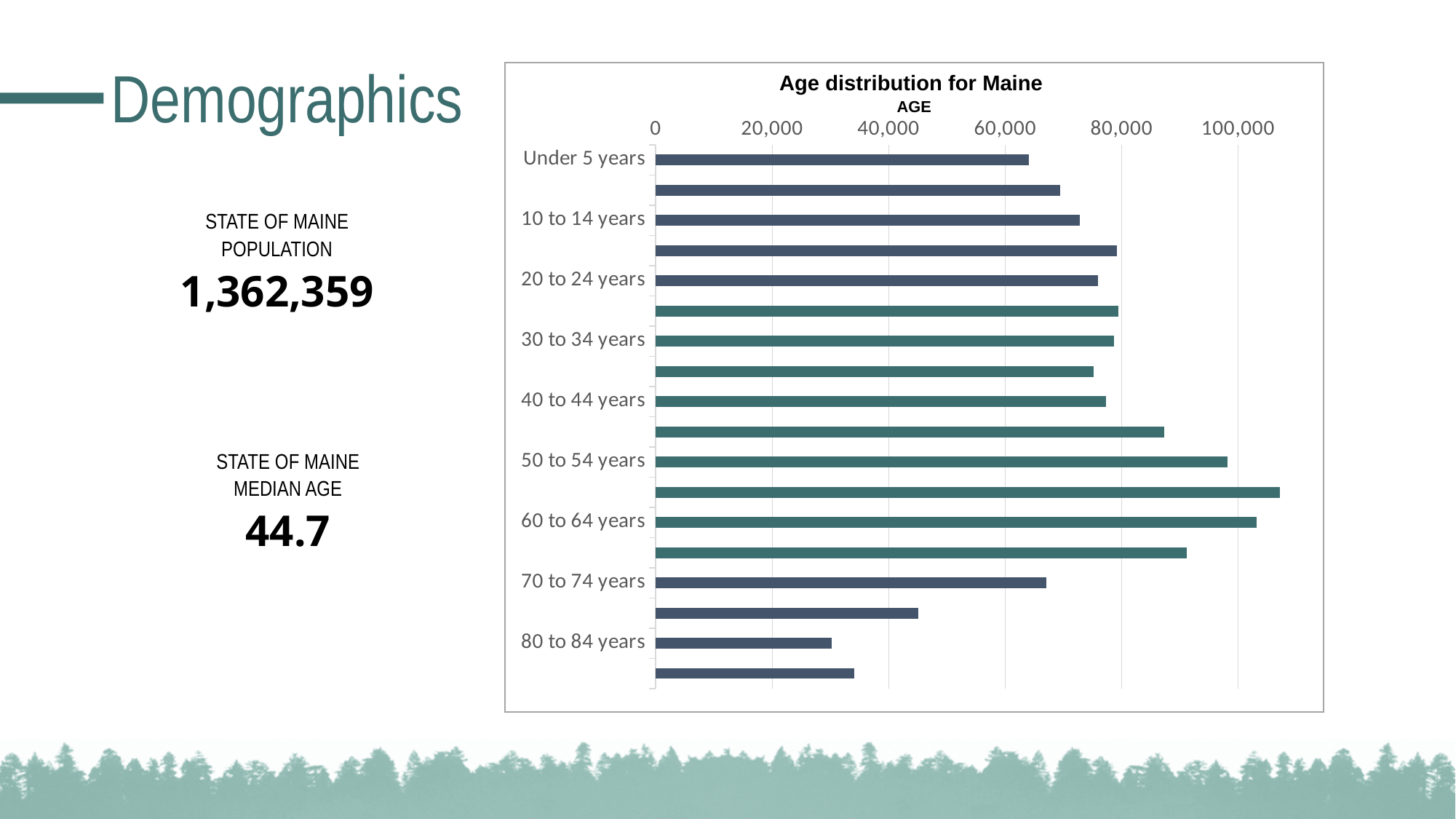
Is the value for 60 to 64 years greater or less than 100,000? greater What kind of chart is shown on the slide? bar chart What is the highest value labelled on the chart's horizontal axis? 100,000 Is the value for Under 5 years greater or less than 60,000? greater Which is larger, the value for 60 to 64 years or the value for Under 5 years? 60 to 64 years Which labelled age group has the lowest value in the chart? 80 to 84 years How many bars are plotted in the chart? 18 Is the value for 50 to 54 years greater or less than 80,000? greater What is the title of the chart? Age distribution for Maine Which is larger, the value for 70 to 74 years or the value for 80 to 84 years? 70 to 74 years